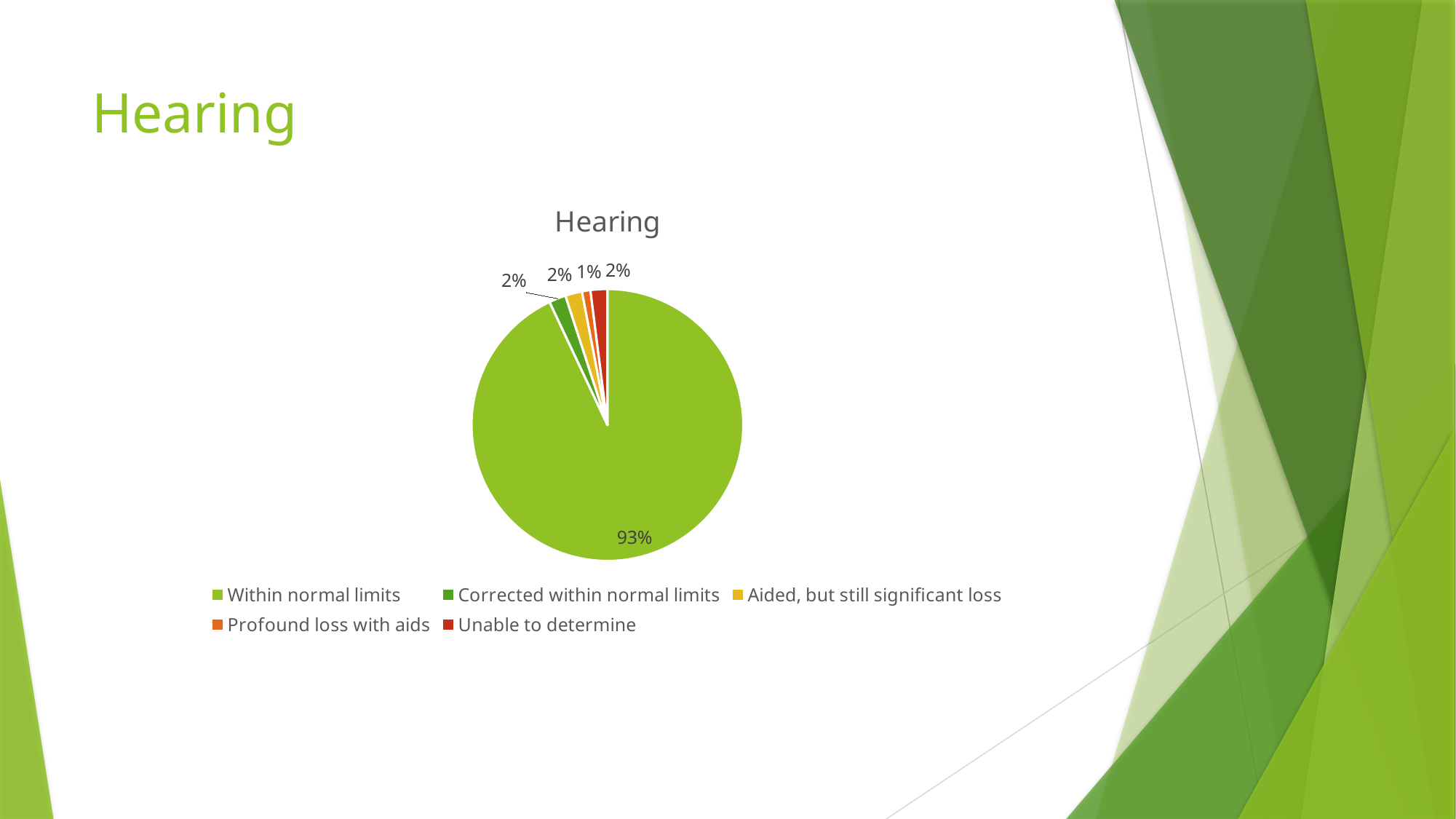
Which category has the smallest share of the pie? Profound loss with aids What percentage is shown for 'Profound loss with aids'? 1% What type of chart is shown on the slide? Pie chart How many slices does the pie chart have? 5 What is the difference in percentage points between 'Within normal limits' and 'Corrected within normal limits'? 91 What percentage of the pie is 'Within normal limits'? 93% Which is larger, the share for 'Unable to determine' or the share for 'Profound loss with aids'? Unable to determine What percentage is shown for 'Unable to determine'? 2% What is the title of the chart? Hearing Which category has the largest share of the pie? Within normal limits How many categories does the legend list? 5 What percentage is shown for 'Aided, but still significant loss'? 2%